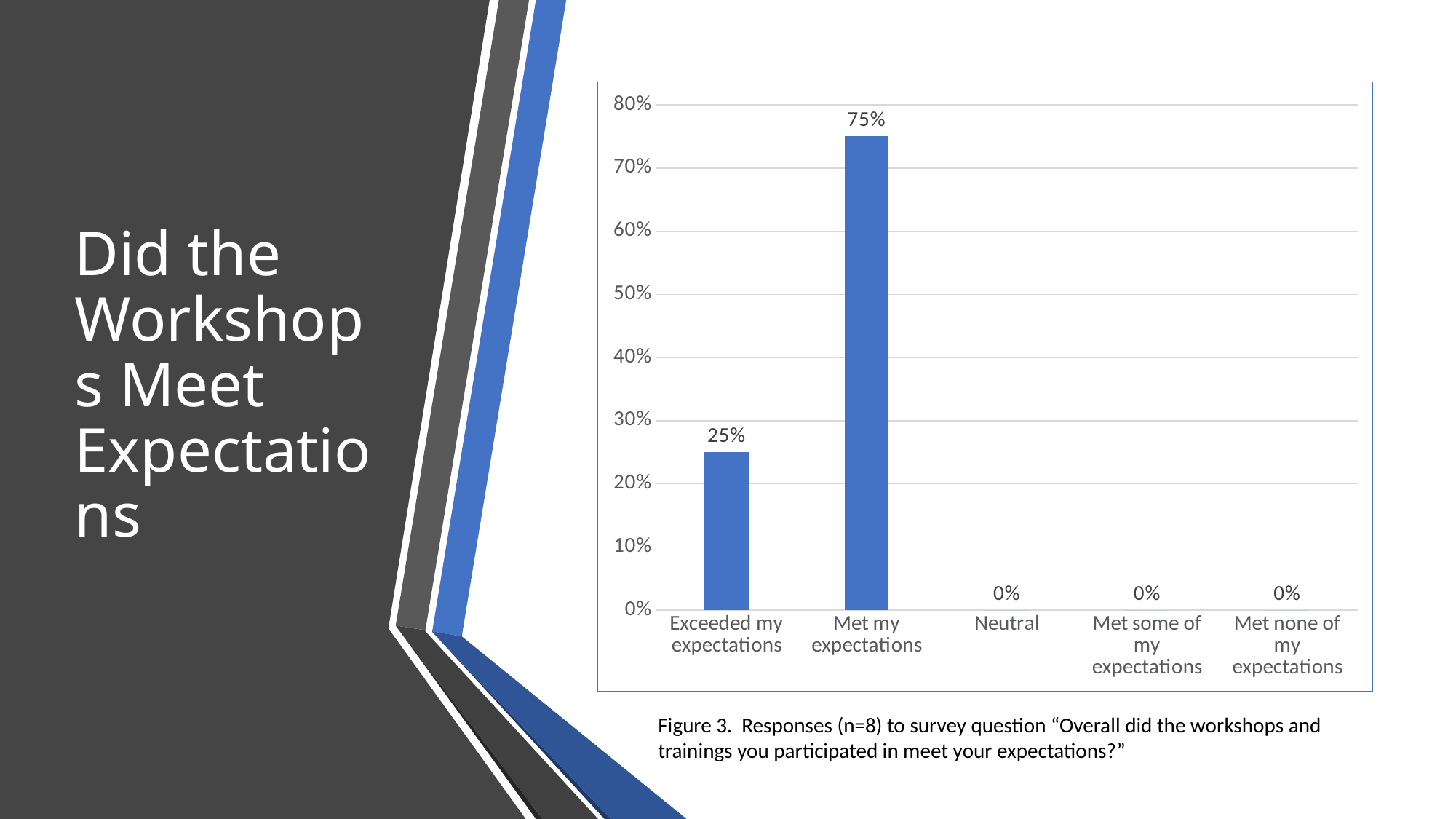
According to the figure caption, how many responses (n) does the chart represent? 8 How many categories are shown on the x axis? 5 What percentage of respondents said the workshops met their expectations? 75% What is the value shown for the Neutral category? 0% Which category has the highest value? Met my expectations Which is larger, the value for 'Exceeded my expectations' or the value for 'Met my expectations'? Met my expectations What is the difference between the values for 'Met my expectations' and 'Exceeded my expectations'? 50% What is the value shown for 'Met some of my expectations'? 0% What kind of chart is shown on the slide? bar chart How many categories have a value of 0%? 3 Is the value for 'Met my expectations' greater or less than 70%? greater What percentage of respondents said the workshops exceeded their expectations? 25%